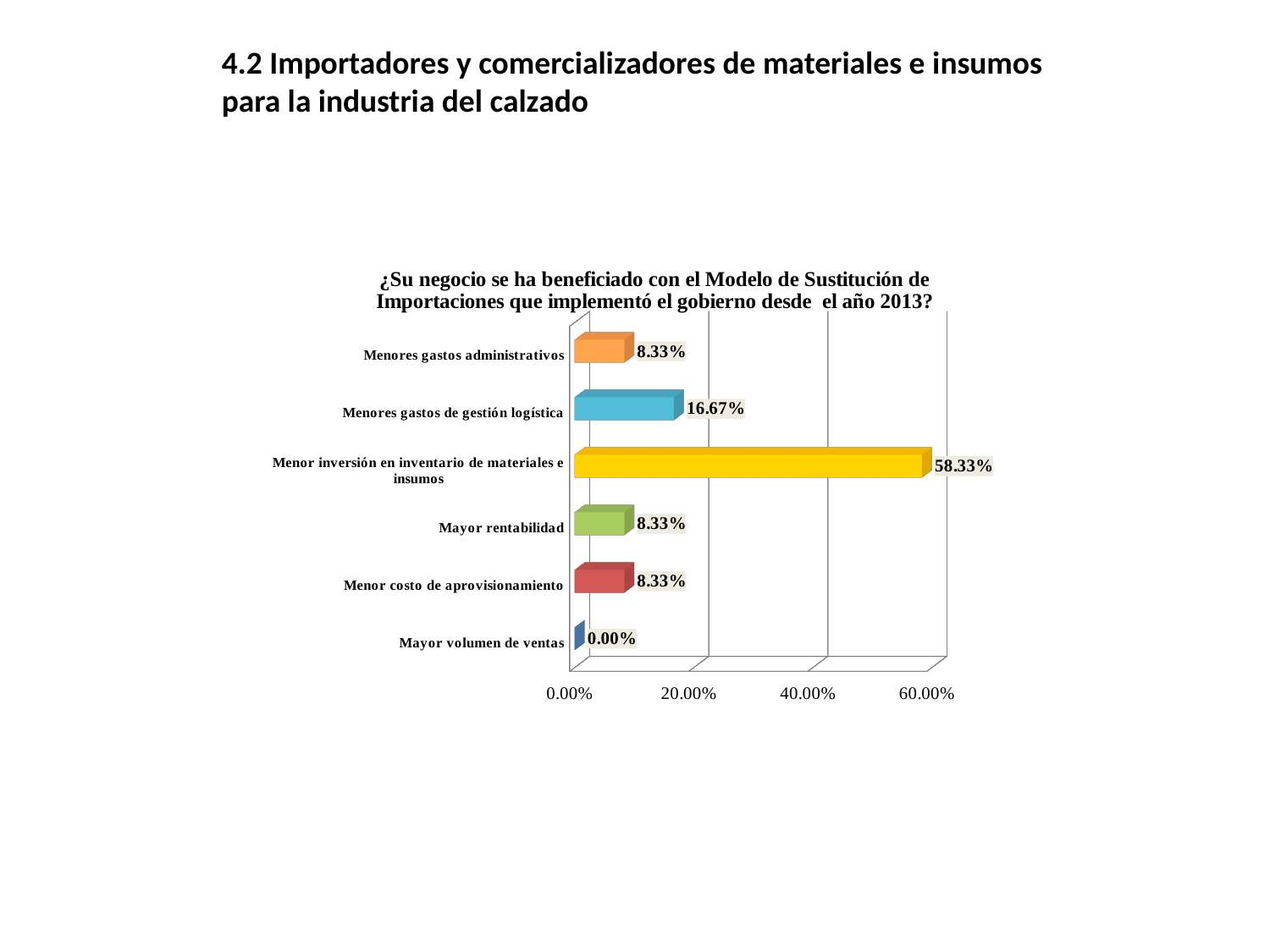
What is the value for "Menor inversión en inventario de materiales e insumos"? 58.33% Which category has the lowest value? Mayor volumen de ventas What is the difference between the values for "Menor inversión en inventario de materiales e insumos" and "Menores gastos de gestión logística"? 41.66% What kind of chart is shown on the slide? Bar chart How many categories are shown in the chart? 6 What is the value for "Menores gastos de gestión logística"? 16.67% Which is larger, the value for "Menores gastos de gestión logística" or the value for "Mayor rentabilidad"? Menores gastos de gestión logística Which category has the highest value? Menor inversión en inventario de materiales e insumos What is the value for "Mayor volumen de ventas"? 0.00% Is the value for "Menor inversión en inventario de materiales e insumos" greater or less than 40.00%? greater What is the value for "Menores gastos administrativos"? 8.33% How many categories have a value of 8.33%? 3